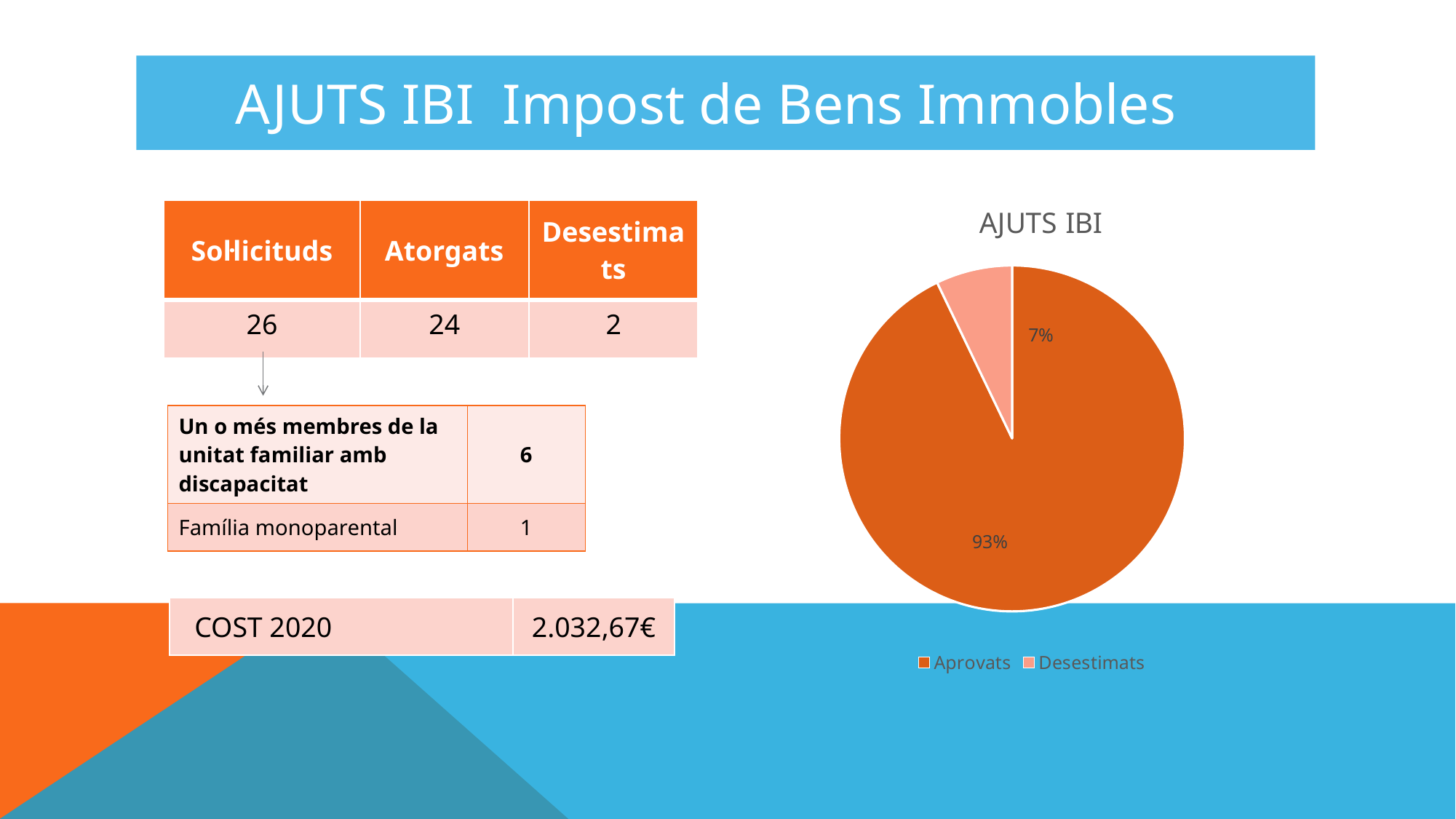
Which slice of the pie is the largest? Aprovats What is the difference in percentage points between the Aprovats and Desestimats slices? 86 What is the title of the chart? AJUTS IBI How many slices does the pie chart have? 2 Which slice of the pie is the smallest? Desestimats What share of the pie does Desestimats represent? 7% What kind of chart is shown on the slide? pie chart Which is larger, the Aprovats slice or the Desestimats slice? Aprovats Which legend entry is shown in the lighter salmon colour? Desestimats How many entries does the legend list? 2 What share of the pie does Aprovats represent? 93%